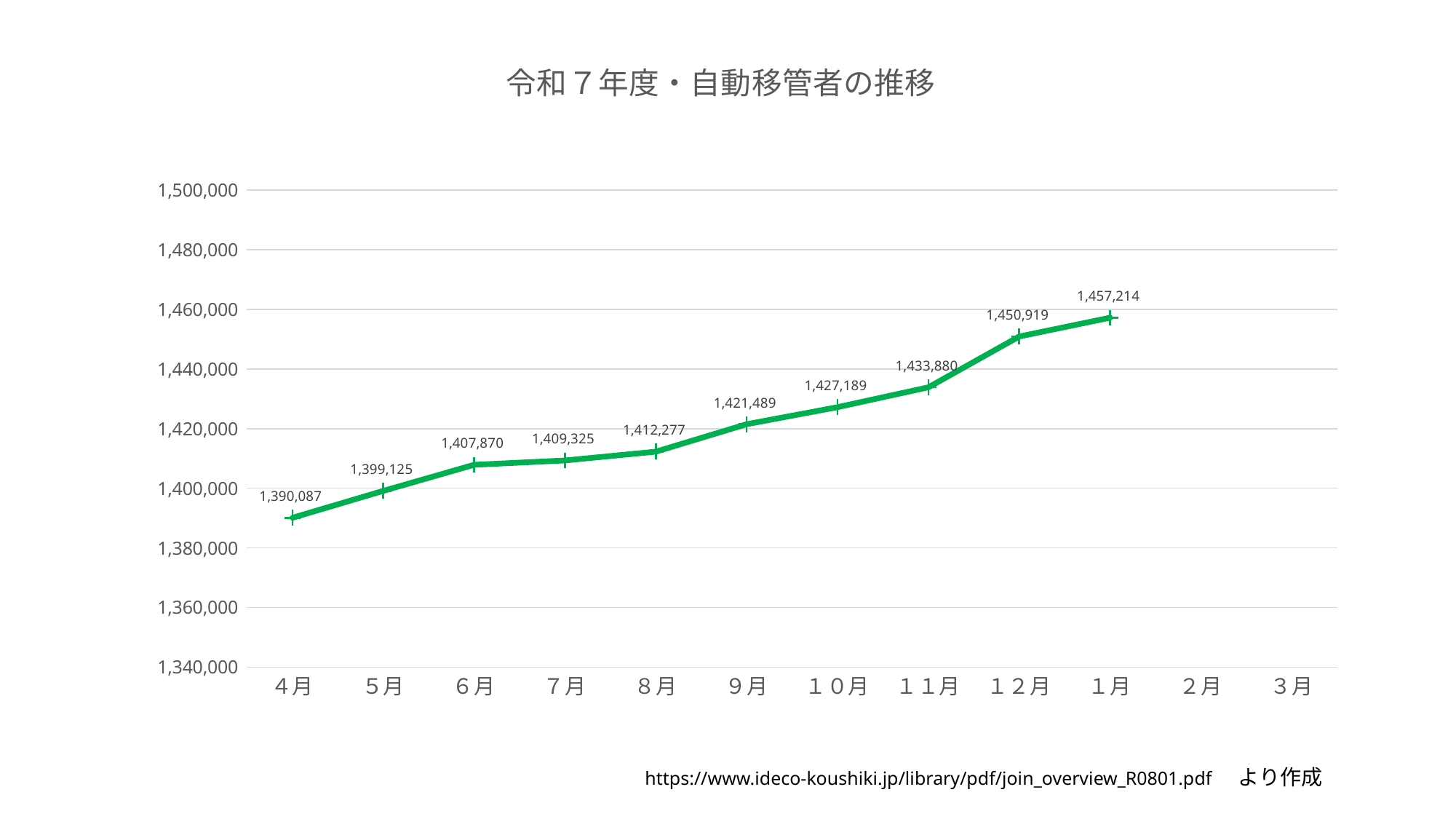
How many months have a plotted data point? 10 Which month has the lowest value? 4月 What is the difference between the values for 12月 and 11月? 17,039 What is the difference between the values for 1月 and 4月? 67,127 What kind of chart is this? line chart What is the value for 9月? 1,421,489 Which is larger, the value for 7月 or the value for 10月? 10月 What is the value for 1月? 1,457,214 What is the value for 4月? 1,390,087 What is the value for 12月? 1,450,919 Which month has the highest value? 1月 Is the value for 8月 greater or less than 1,420,000? less